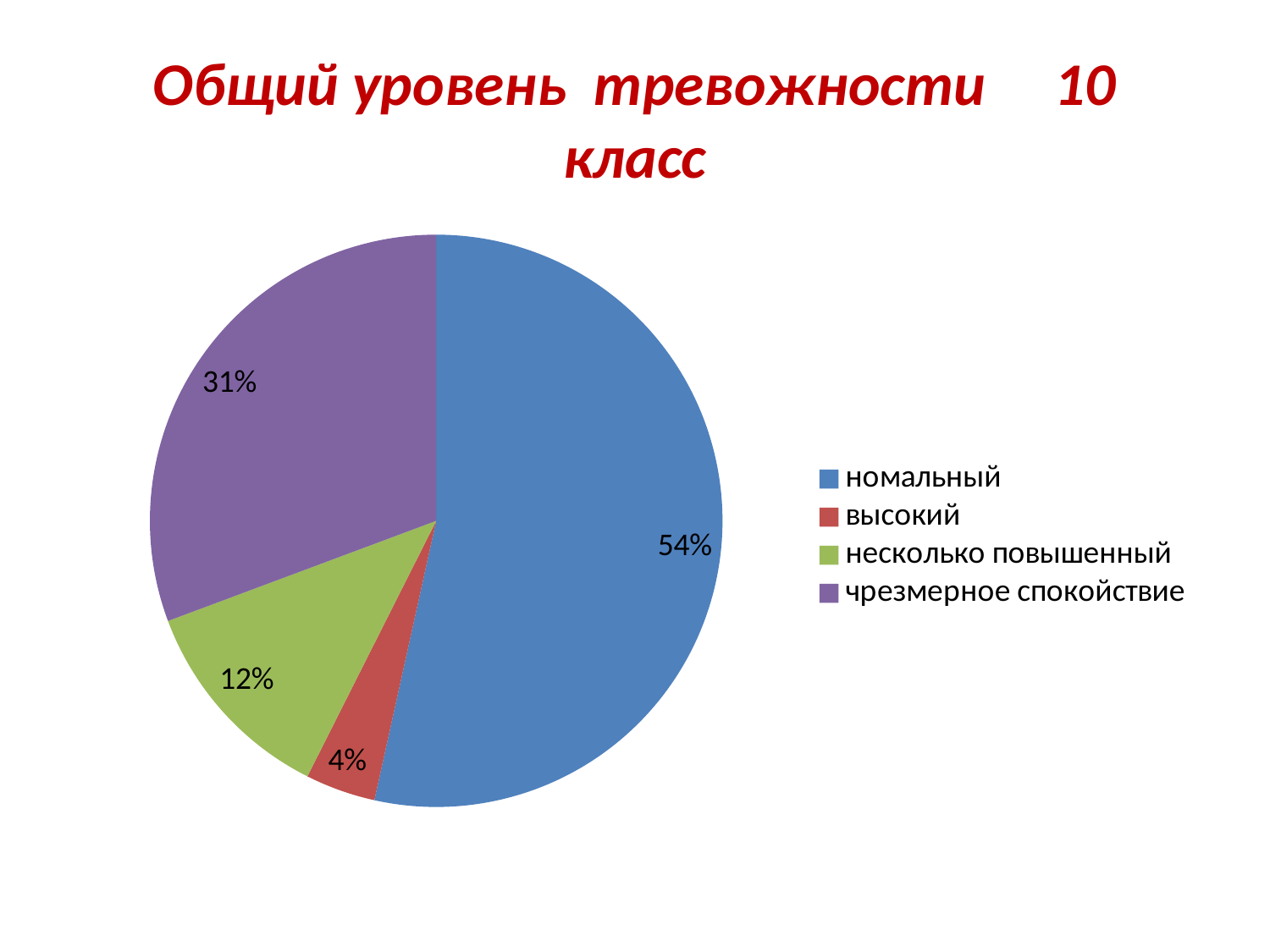
Which is larger, the value for "несколько повышенный" or the value for "высокий"? несколько повышенный What is the value for "высокий"? 4% What is the value for "чрезмерное спокойствие"? 31% How many slices does the pie chart have? 4 Which category has the largest share of the pie? номальный What is the value for "номальный"? 54% What is the title of the chart? Общий уровень тревожности 10 класс What is the difference between the values for "номальный" and "чрезмерное спокойствие"? 23% What kind of chart is shown on the slide? pie chart Which category has the smallest share of the pie? высокий What is the value for "несколько повышенный"? 12% What colour is the slice for "чрезмерное спокойствие"? purple